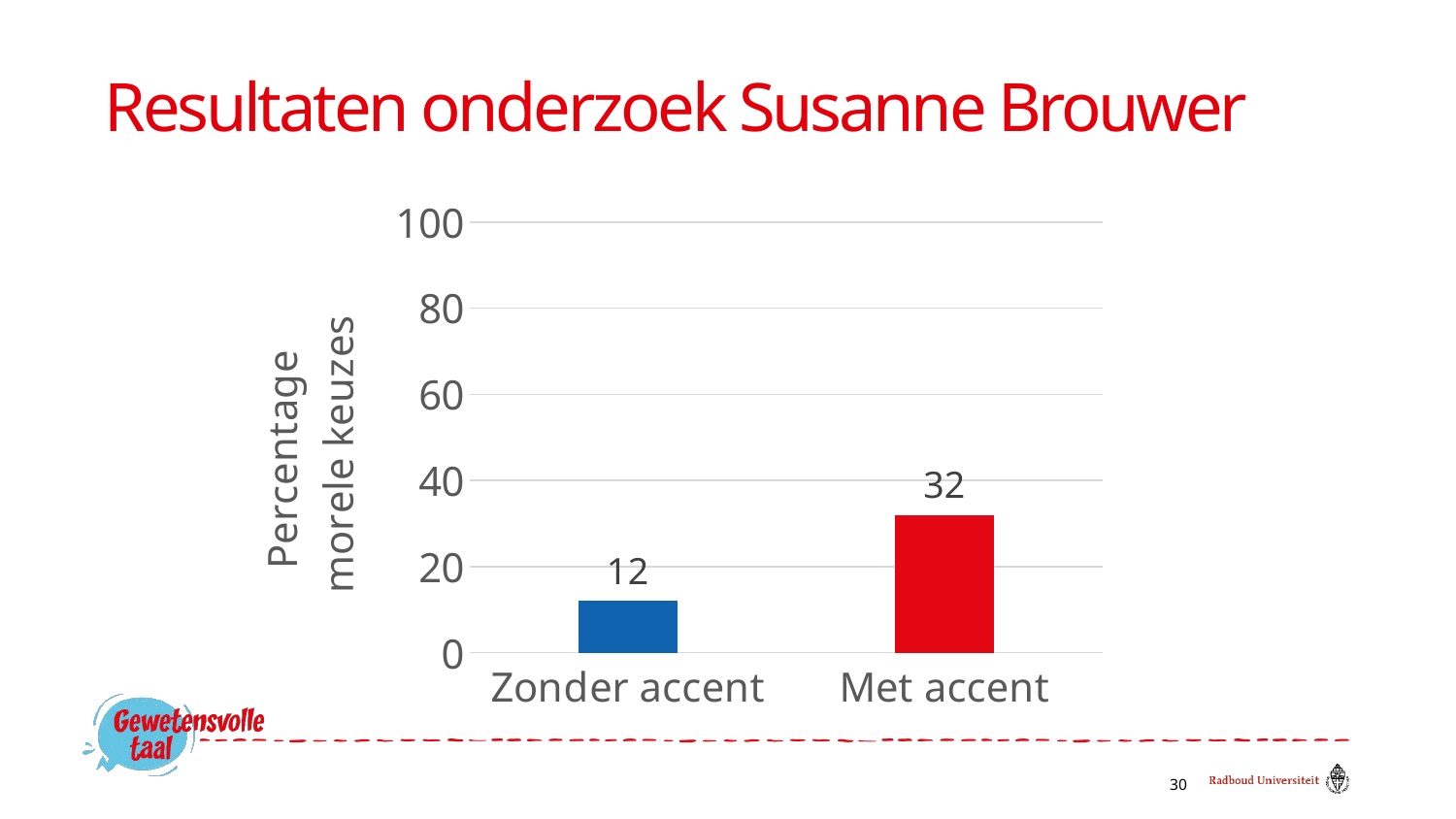
Is the value for "Met accent" greater or less than 40? less How many categories are shown on the x axis? 2 What colour is the bar for "Met accent"? Red What is the value for "Zonder accent"? 12 Which category has the highest value? Met accent What is the value for "Met accent"? 32 Which category has the lowest value? Zonder accent What is the label of the vertical axis? Percentage morele keuzes Which is larger, the value for "Zonder accent" or the value for "Met accent"? Met accent Is the value for "Zonder accent" greater or less than 20? less What is the difference between the values for "Met accent" and "Zonder accent"? 20 What kind of chart is shown on the slide? Bar chart